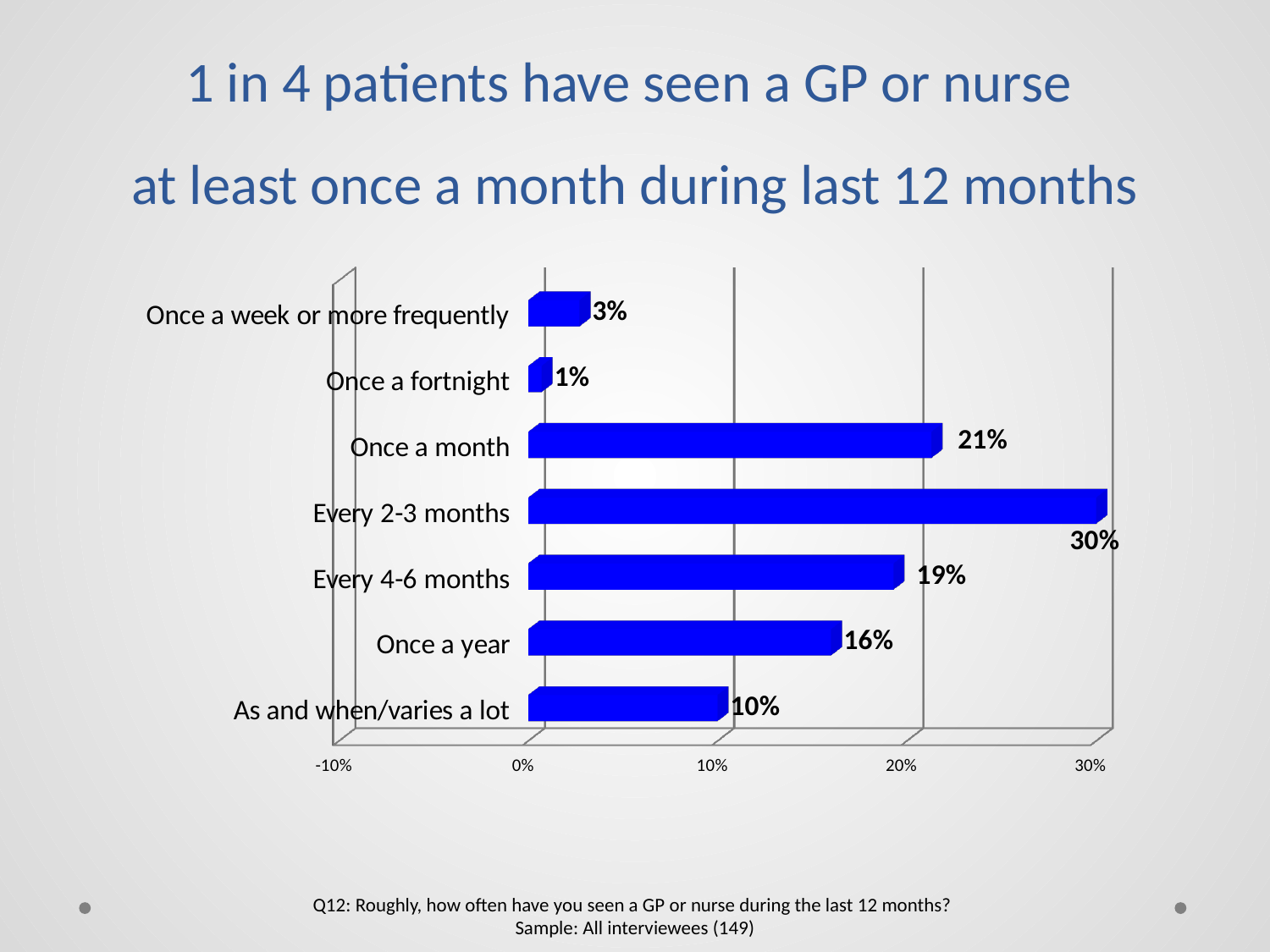
What is the difference between 'Every 4-6 months' and 'Once a year'? 3% What is the sample size stated at the bottom of the slide? 149 What percentage of patients saw a GP or nurse once a month? 21% Which is larger, the value for 'Once a year' or the value for 'Every 4-6 months'? Every 4-6 months Is the value for 'Once a month' greater or less than 20%? greater What is the difference between the values for 'Every 2-3 months' and 'Once a month'? 9% What percentage is shown for 'As and when/varies a lot'? 10% Which category has the lowest value? Once a fortnight Which category has the highest value? Every 2-3 months What is the value for 'Every 2-3 months'? 30% How many categories are shown in the chart? 7 What type of chart is shown on the slide? Bar chart